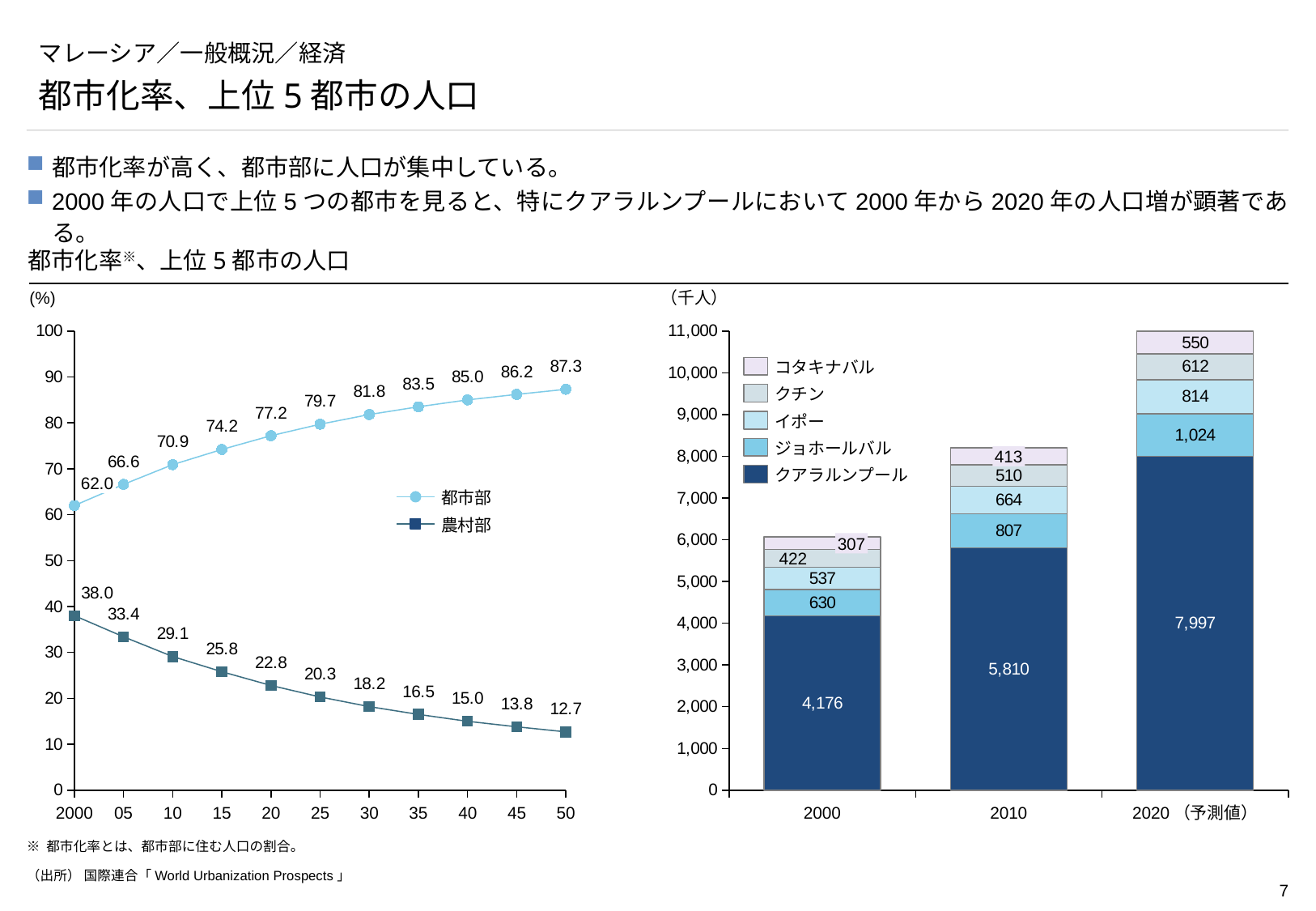
右の上位5都市の人口のグラフで、2020年（予測値）のジョホールバルの値はいくつですか？ 1,024 右の上位5都市の人口のグラフで、2020年（予測値）のクアラルンプールと2000年のクアラルンプールの差はいくつですか？ 3,821 左の都市化率のグラフで、都市部の値は2000年から2050年にかけて上昇していますか、下降していますか？ 上昇 左の都市化率のグラフで、2050年（50）の農村部の値はいくつですか？ 12.7 右の上位5都市の人口のグラフで、2010年のクアラルンプールの値はいくつですか？ 5,810 左の都市化率のグラフは、どの種類のグラフですか？ 折れ線グラフ 左の都市化率のグラフで、2020年の都市部と農村部の値の差はいくつですか？ 54.4 左の都市化率のグラフで、2000年の都市部の値はいくつですか？ 62.0 左の都市化率のグラフの凡例には、いくつの系列がありますか？ 2 右の上位5都市の人口のグラフで、2000年の積み上げ棒の合計はいくつですか？ 6,072 右の上位5都市の人口のグラフの凡例には、いくつの都市が示されていますか？ 5 右の上位5都市の人口のグラフで、2010年のイポーとクチンではどちらの値が大きいですか？ イポー